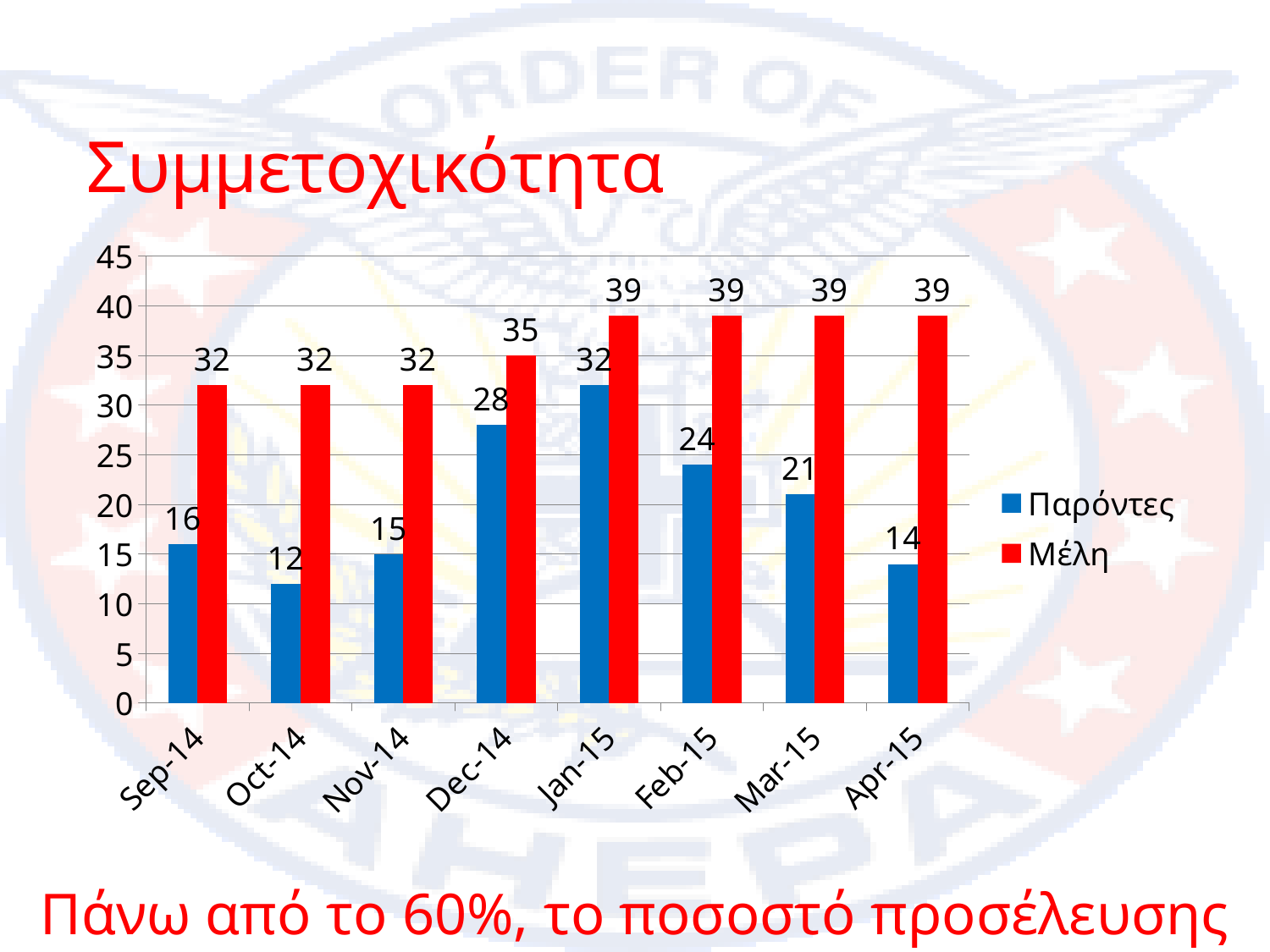
Which month has the lowest value for Παρόντες? Oct-14 How many series does the legend list? 2 What is the value of Παρόντες for Dec-14? 28 What kind of chart is shown on the slide? Bar chart What is the value of Παρόντες for Apr-15? 14 What is the title of the chart on the slide? Συμμετοχικότητα How many months are shown on the x axis? 8 Does the value of Μέλη rise or fall from Sep-14 to Apr-15? Rise What is the difference between Μέλη and Παρόντες in Feb-15? 15 Which is larger, Παρόντες in Mar-15 or Παρόντες in Nov-14? Παρόντες in Mar-15 What is the value of Μέλη for Nov-14? 32 Which month has the highest value for Παρόντες? Jan-15